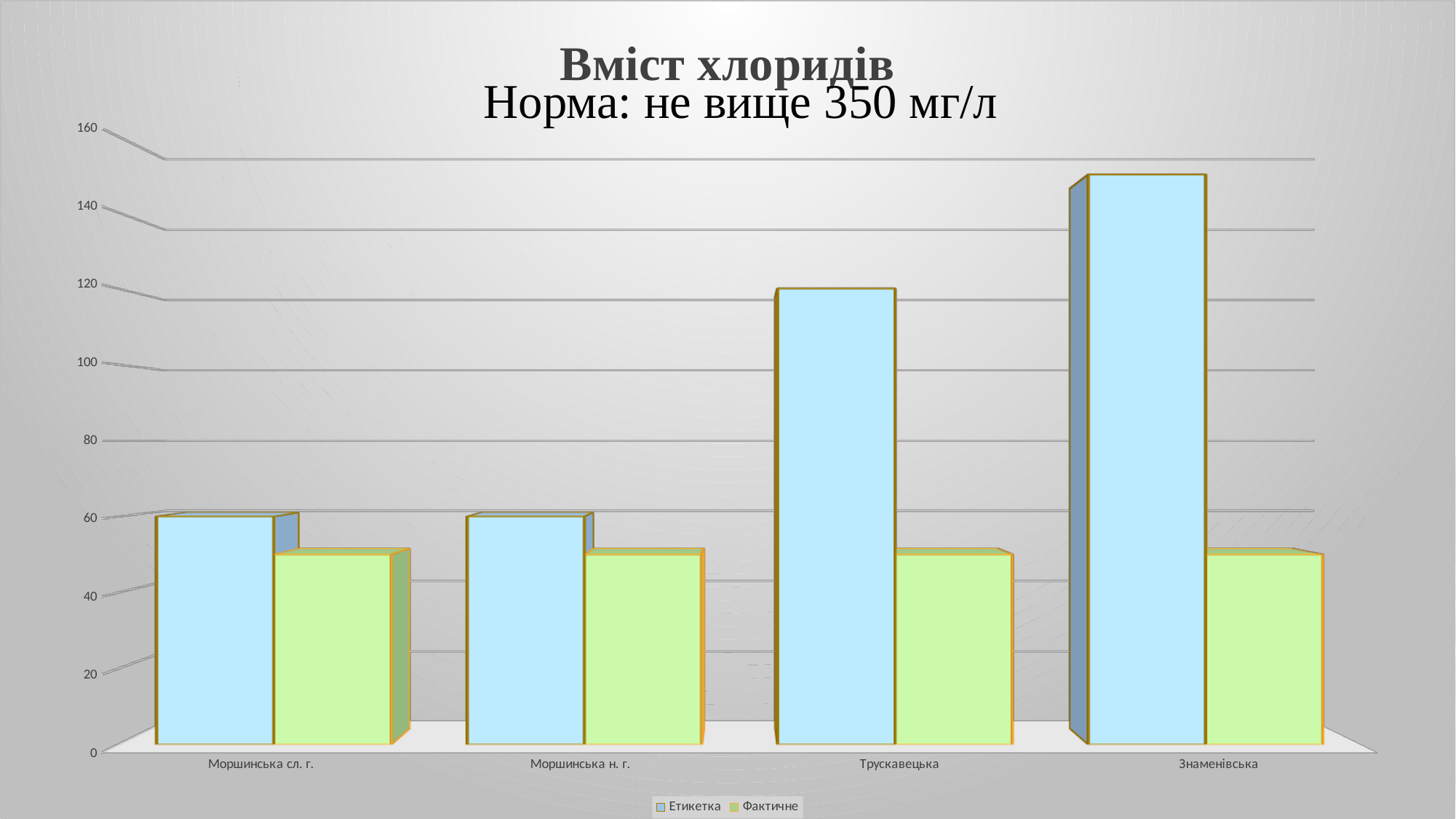
Is the Етикетка value for Трускавецька greater or less than 100? greater What kind of chart is shown on the slide? bar chart Is the Етикетка value for Моршинська сл. г. greater or less than 40? greater Is the Фактичне value for Трускавецька greater or less than 60? less Which category has the highest value for the Етикетка series? Знаменівська Do the Етикетка values rise or fall from left to right across the categories? rise Which series is shown in green? Фактичне For Знаменівська, which is larger: the Етикетка value or the Фактичне value? Етикетка How many series does the legend list? 2 How many categories are shown on the x axis? 4 What is the title of the chart? Вміст хлоридів